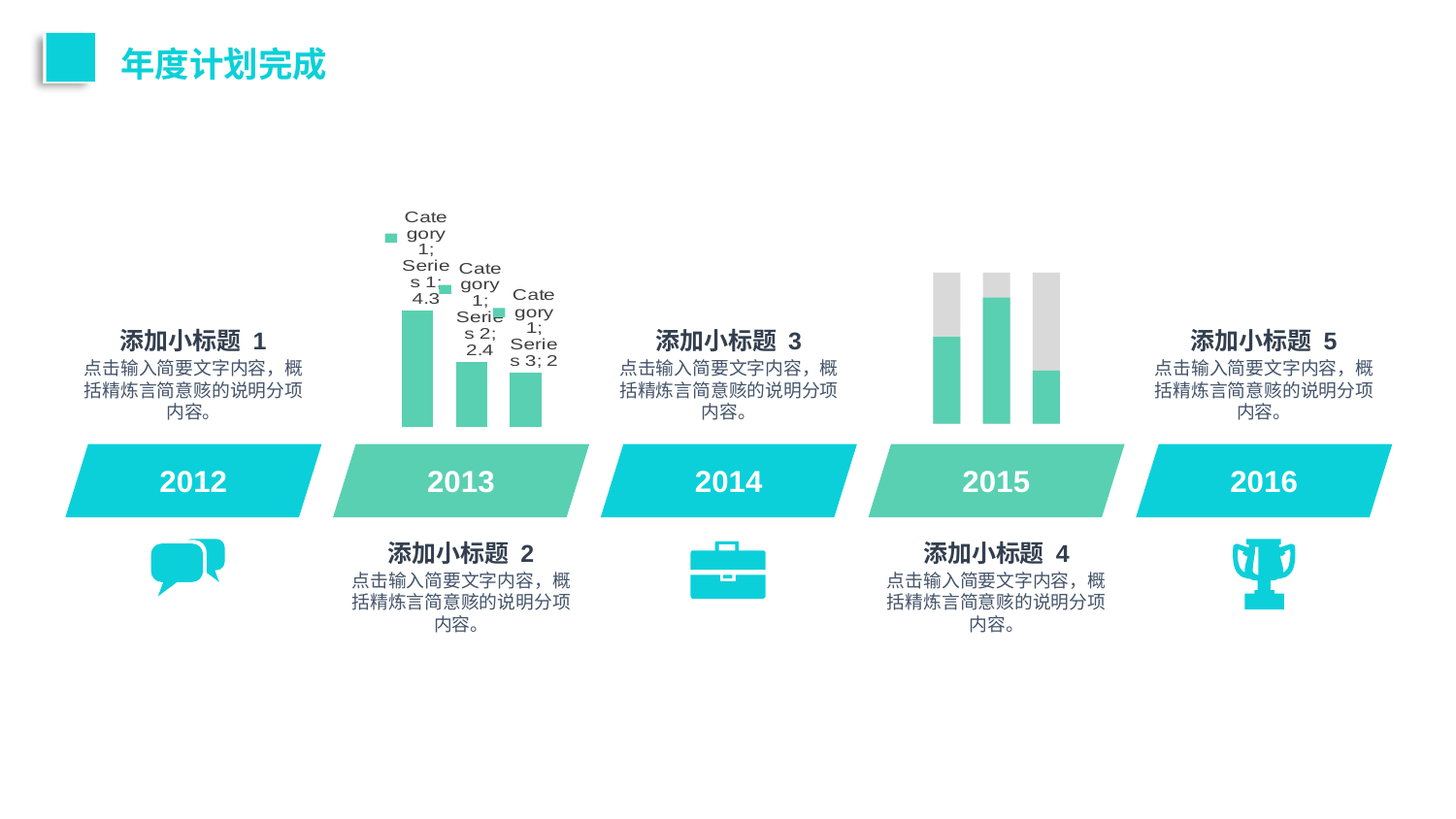
In the chart above 2013, what is the value for Series 2? 2.4 In the chart above 2013, how many bars are plotted? 3 In the chart above 2013, what is the difference between the values for Series 1 and Series 2? 1.9 In the chart above 2013, what is the value for Series 1? 4.3 What kind of chart is shown above 2013? Bar chart In the chart above 2013, what is the value for Series 3? 2 In the chart above 2013, what is the category name shown in the data labels? Category 1 In the chart above 2013, what is the difference between the values for Series 2 and Series 3? 0.4 In the chart above 2013, which series has the lowest value? Series 3 In the chart above 2013, which is larger, the value for Series 1 or the value for Series 3? Series 1 In the chart above 2013, which series has the highest value? Series 1